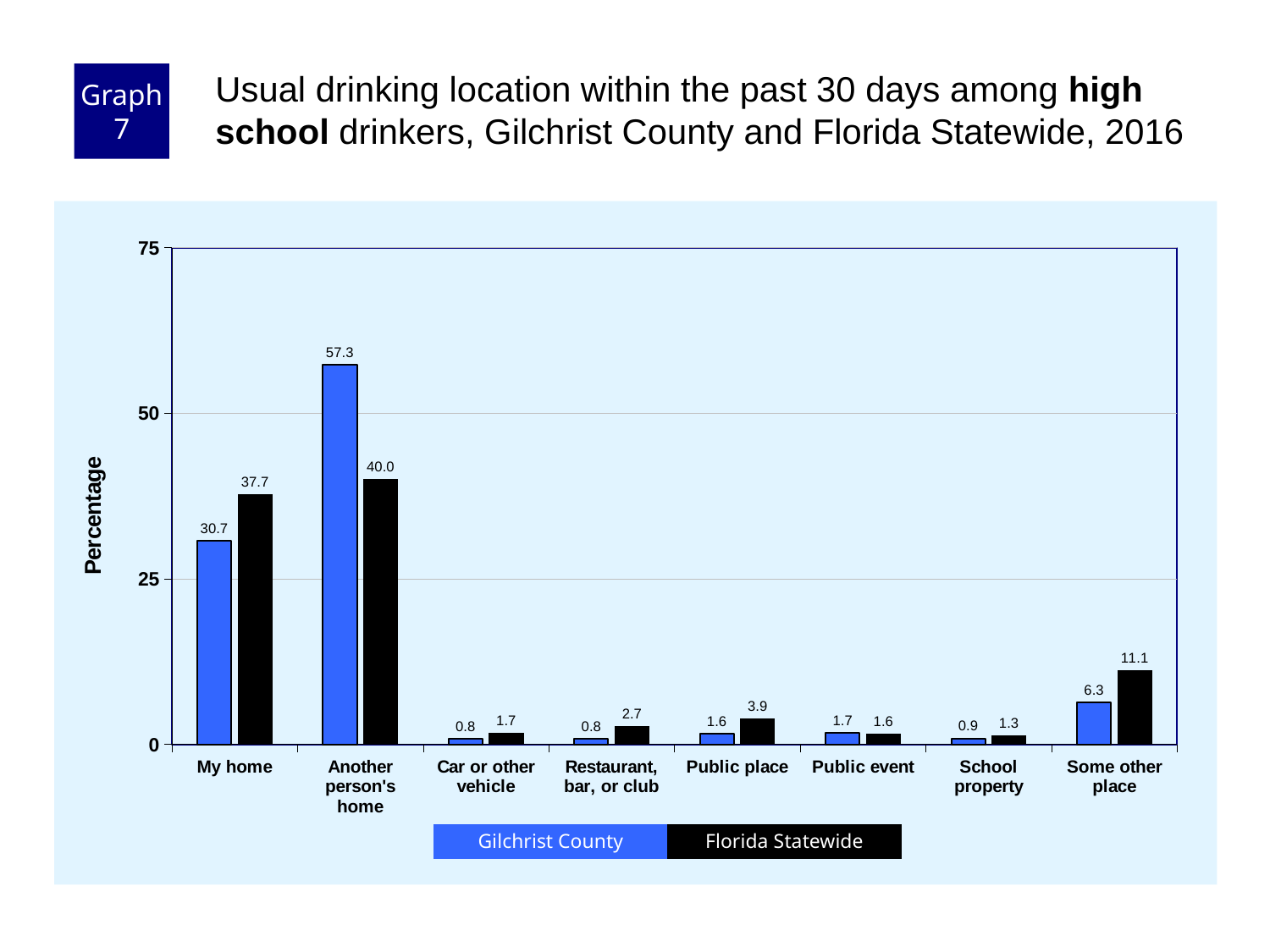
Which is larger for "Public place": the Gilchrist County value or the Florida Statewide value? Florida Statewide How many series does the legend list? 2 Is the Gilchrist County value for "Another person's home" greater or less than 50? greater Which category has the lowest Florida Statewide value? School property What is the Gilchrist County value for "Another person's home"? 57.3 What is the Florida Statewide value for "Some other place"? 11.1 How many location categories are shown on the x axis? 8 What kind of chart is shown on the slide? Bar chart What is the label on the y axis? Percentage What is the Florida Statewide value for "My home"? 37.7 Which category has the highest Gilchrist County value? Another person's home What is the difference between the Gilchrist County and Florida Statewide values for "Another person's home"? 17.3